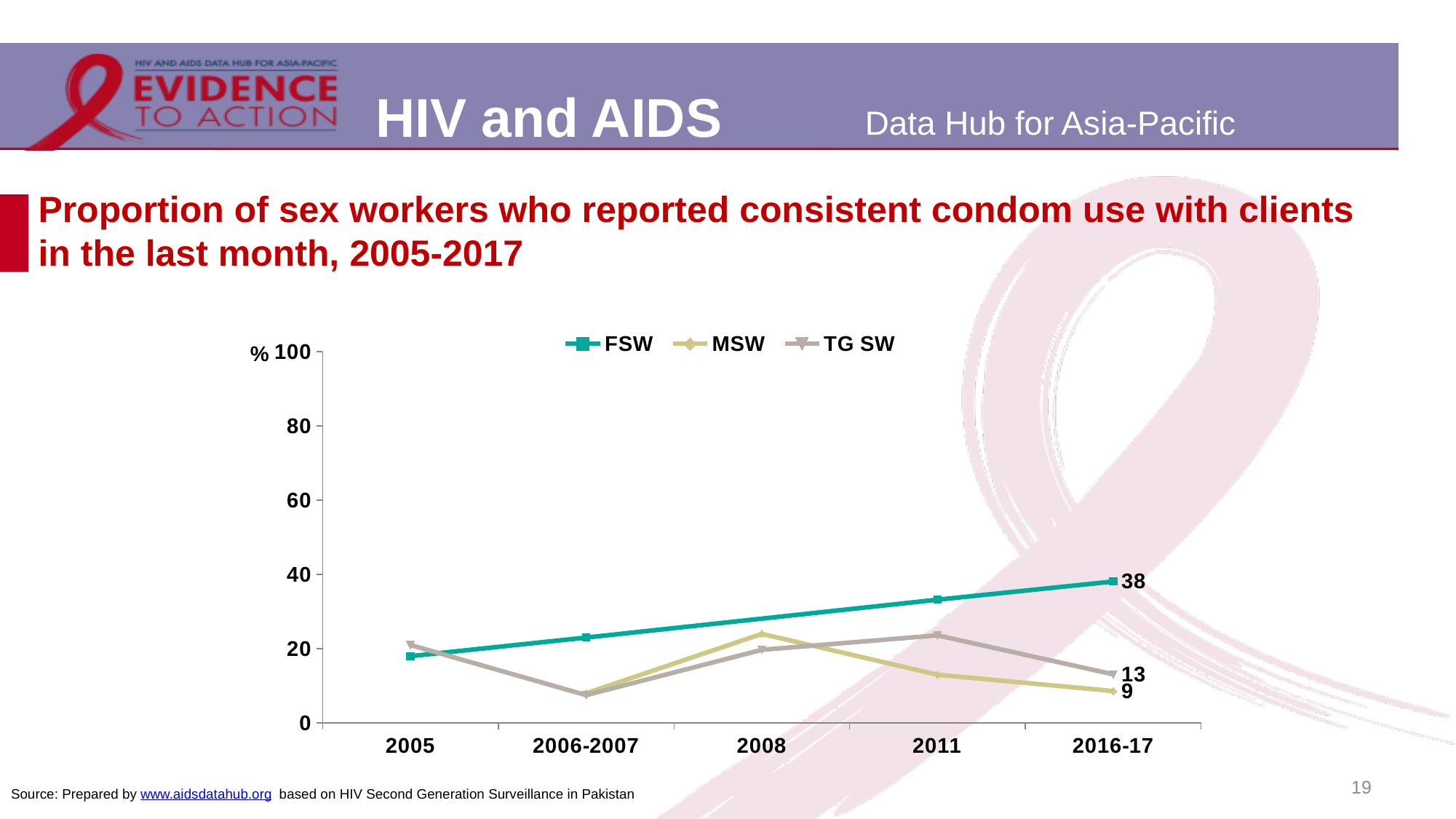
Which series has the highest value in 2016-17? FSW Is the value for FSW in 2016-17 greater or less than 40? less Which series is drawn in teal? FSW Which series has the lowest value in 2016-17? MSW How many series does the legend list? 3 Does the FSW series rise or fall from 2005 to 2016-17? rise What is the value for MSW in 2016-17? 9 What kind of chart is shown on the slide? line chart What is the value for FSW in 2016-17? 38 What is the value for TG SW in 2016-17? 13 How many time points are shown on the x axis? 5 What is the difference between the FSW and MSW values in 2016-17? 29